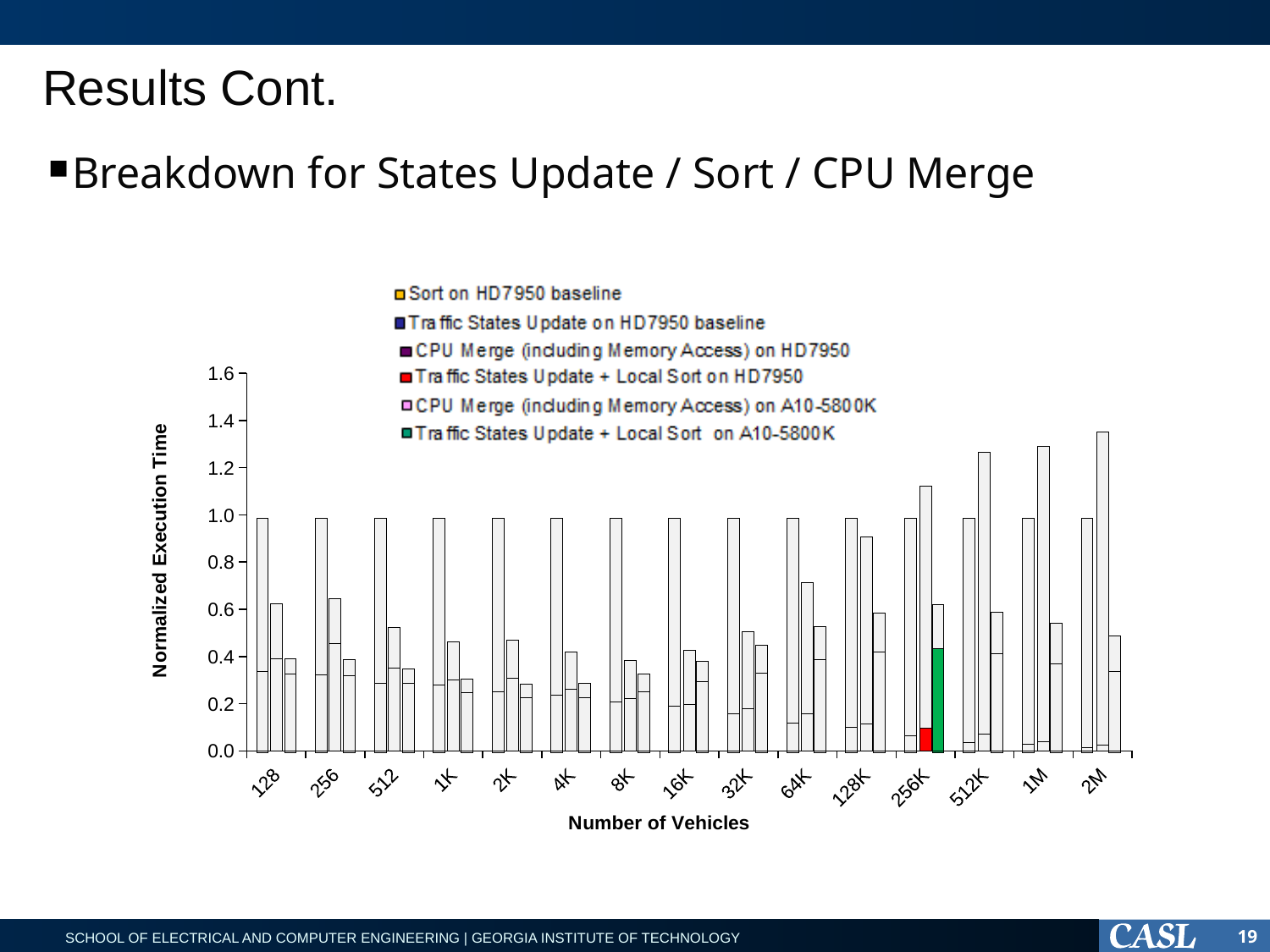
How many categories are shown on the x axis (Number of Vehicles)? 15 What is the title of the y axis? Normalized Execution Time Is the tallest bar in the 64K group greater or less than 0.6? greater What is the title of the x axis? Number of Vehicles Which is taller: the tallest bar in the 2M group or the tallest bar in the 128 group? 2M Is the tallest bar in the 2M group greater or less than 1.2? greater What kind of chart is shown on the slide? bar chart Which Number of Vehicles category contains the tallest bar in the chart? 2M How many series does the legend list? 6 Is the tallest bar in the 1M group greater or less than 1.2? greater